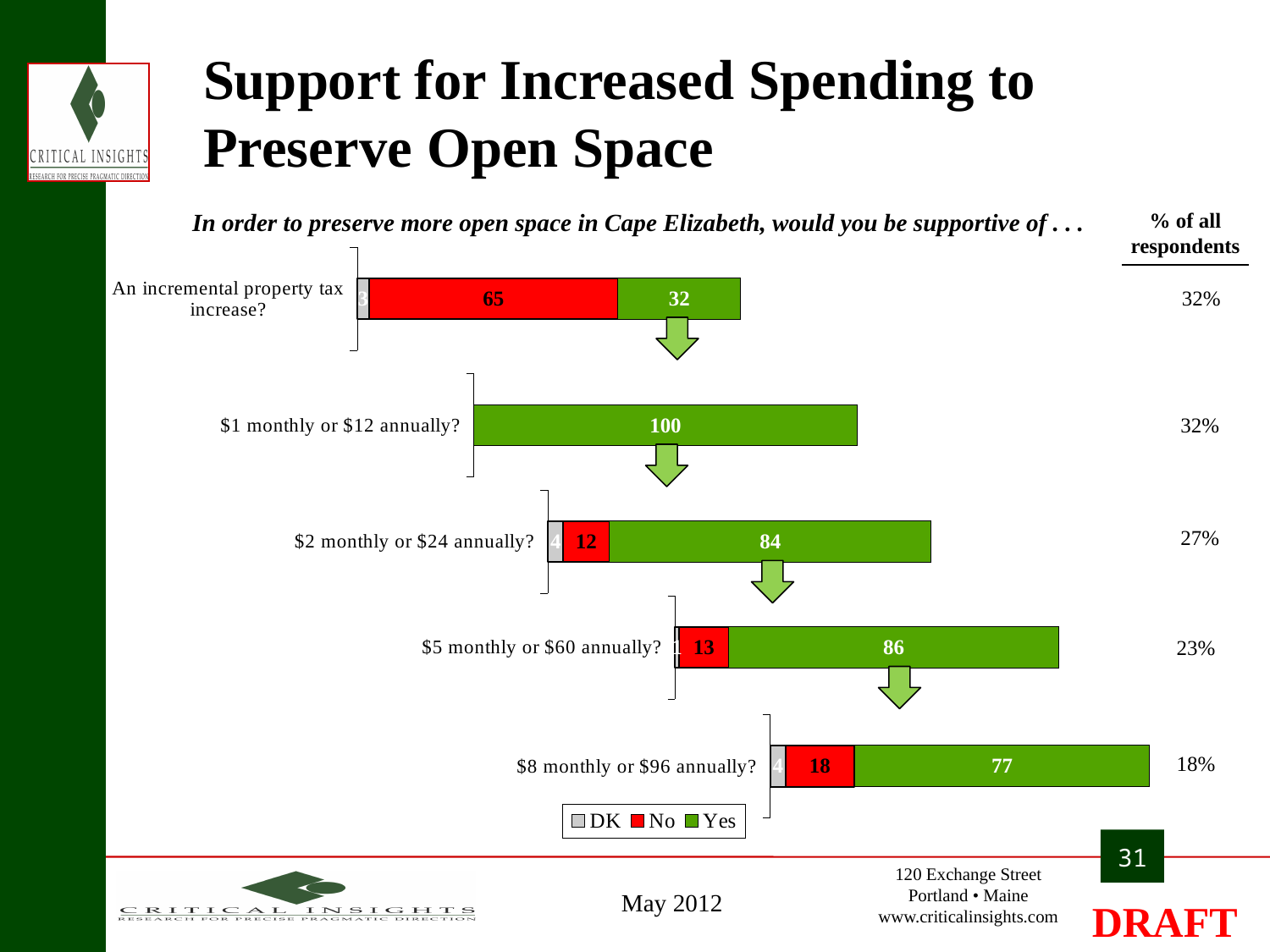
How many categories are shown in the chart? 5 What is the Yes value for "$8 monthly or $96 annually?" 77 How many series does the legend list? 3 What percentage answered Yes to "$2 monthly or $24 annually?" 84 What percentage answered No to "An incremental property tax increase?" 65 What is the No value for "$5 monthly or $60 annually?" 13 What is the "% of all respondents" value shown for "$5 monthly or $60 annually?" 23% Which is larger: the No value for "$8 monthly or $96 annually?" or the No value for "$2 monthly or $24 annually?" $8 monthly or $96 annually? What kind of chart is shown on the slide? Stacked bar chart Which category has the highest Yes value? $1 monthly or $12 annually? Which category has the lowest Yes value? An incremental property tax increase? What is the difference between the Yes values for "$5 monthly or $60 annually?" and "$8 monthly or $96 annually?" 9